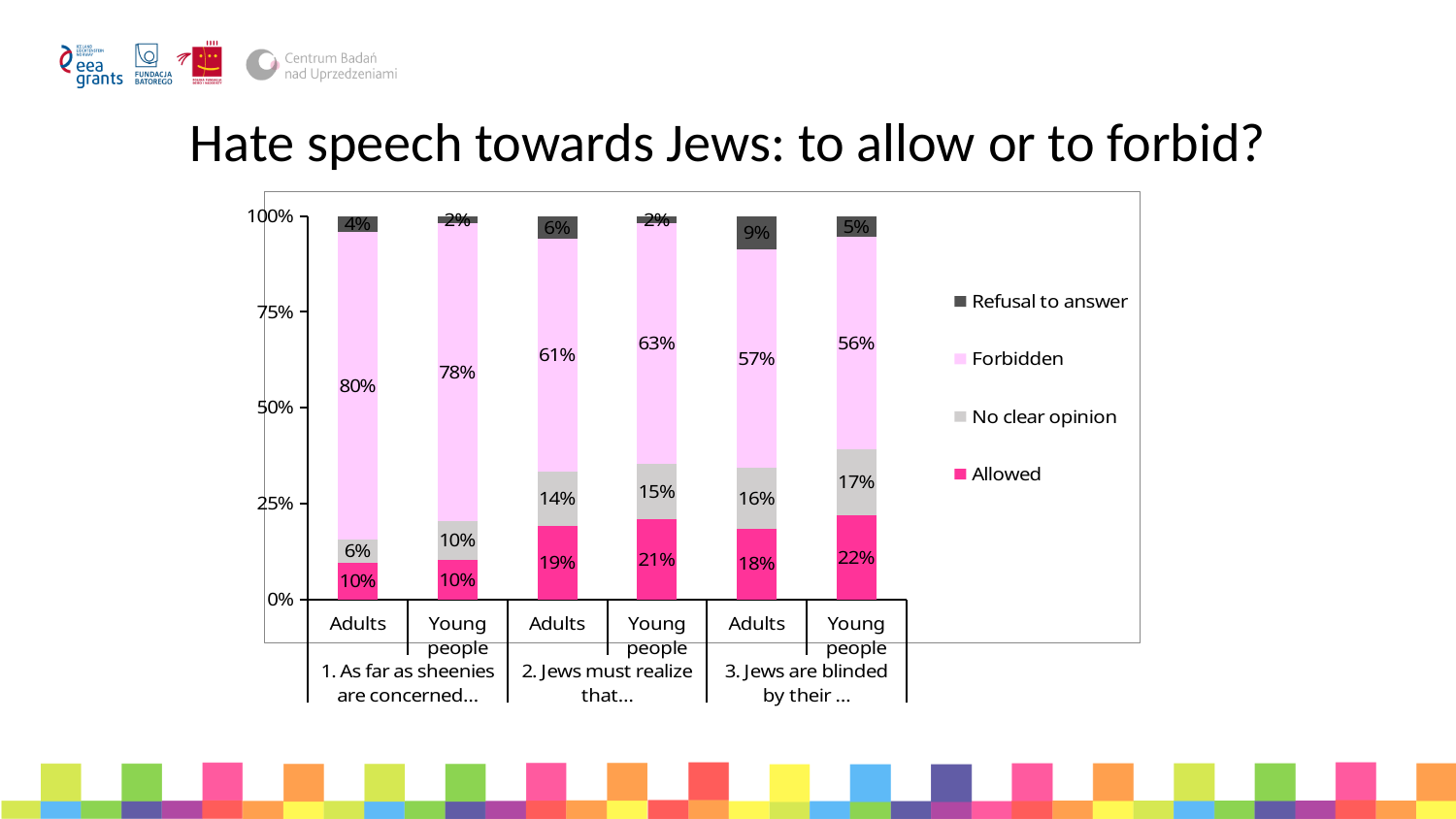
What is the 'No clear opinion' value for Adults under statement 2 ('Jews must realize that...')? 14% Which is larger: the 'Allowed' value for Adults or for Young people under statement 3 ('Jews are blinded by their ...')? Young people What is the 'Forbidden' value for Adults under statement 1 ('As far as sheenies are concerned...')? 80% What is the 'Allowed' value for Young people under statement 3 ('Jews are blinded by their ...')? 22% What kind of chart is shown on the slide? Stacked bar chart What is the 'Refusal to answer' value for Adults under statement 3 ('Jews are blinded by their ...')? 9% Which bar has the highest 'Forbidden' value? Adults, statement 1 (As far as sheenies are concerned...) Which bar has the lowest 'Allowed' value? Adults and Young people under statement 1 (both 10%) How many series does the legend list? 4 How many bars are plotted in the chart? 6 What is the difference between the 'Forbidden' values for Adults and Young people under statement 2 ('Jews must realize that...')? 2 percentage points Which legend entry is shown in dark grey? Refusal to answer